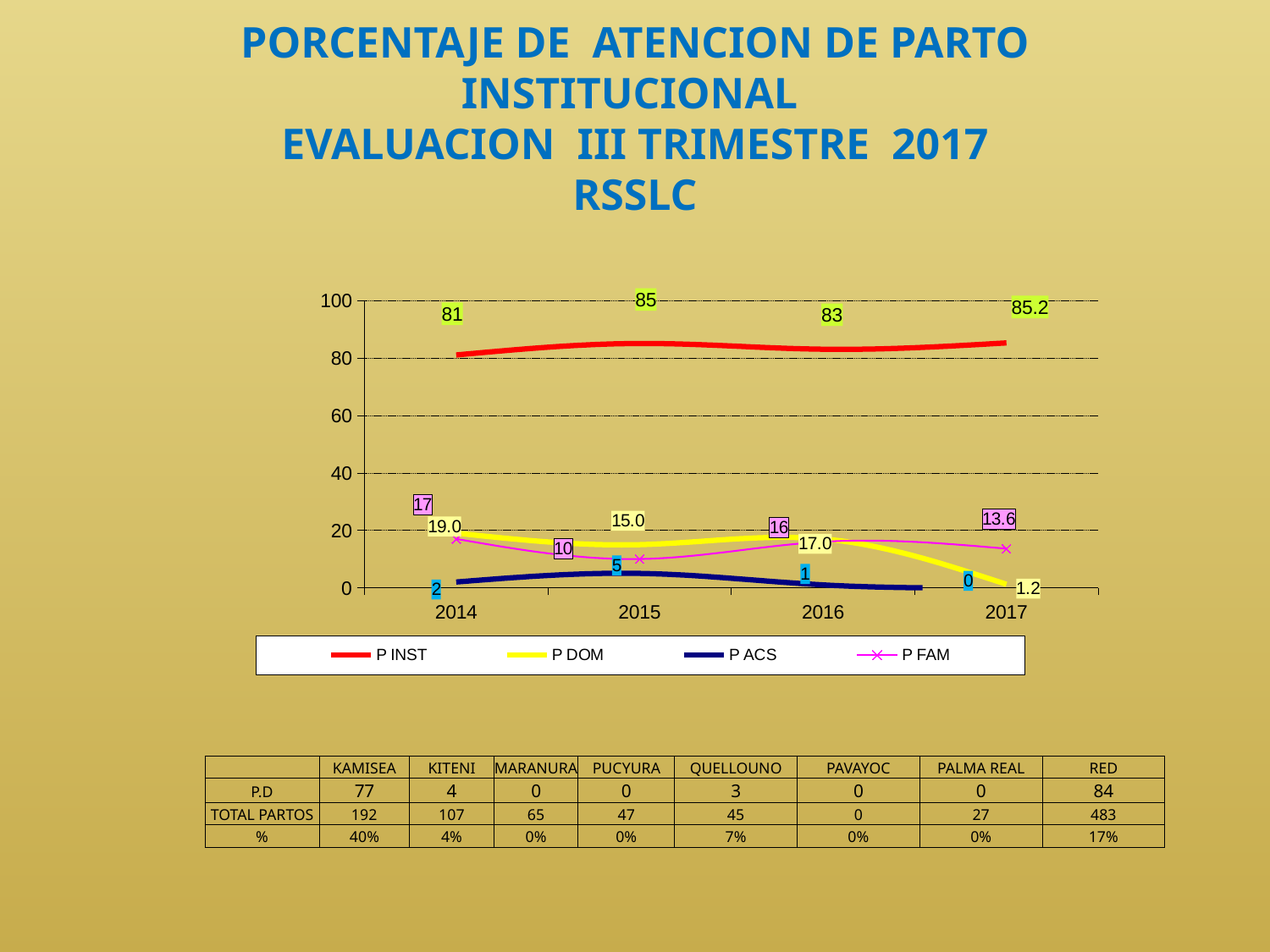
What is the difference between P INST in 2015 and P INST in 2014? 4 What is the value of P FAM in 2015? 10 Which is larger in 2016, P DOM or P FAM? P DOM In which year is P INST highest? 2017 What is the value of P ACS in 2016? 1 How many years are shown on the x axis? 4 In which year is P DOM lowest? 2017 How many series does the legend list? 4 What is the value of P INST in 2017? 85.2 Is the value for P INST in 2014 greater or less than 80? greater What kind of chart is shown on the slide? line chart What is the value of P DOM in 2014? 19.0